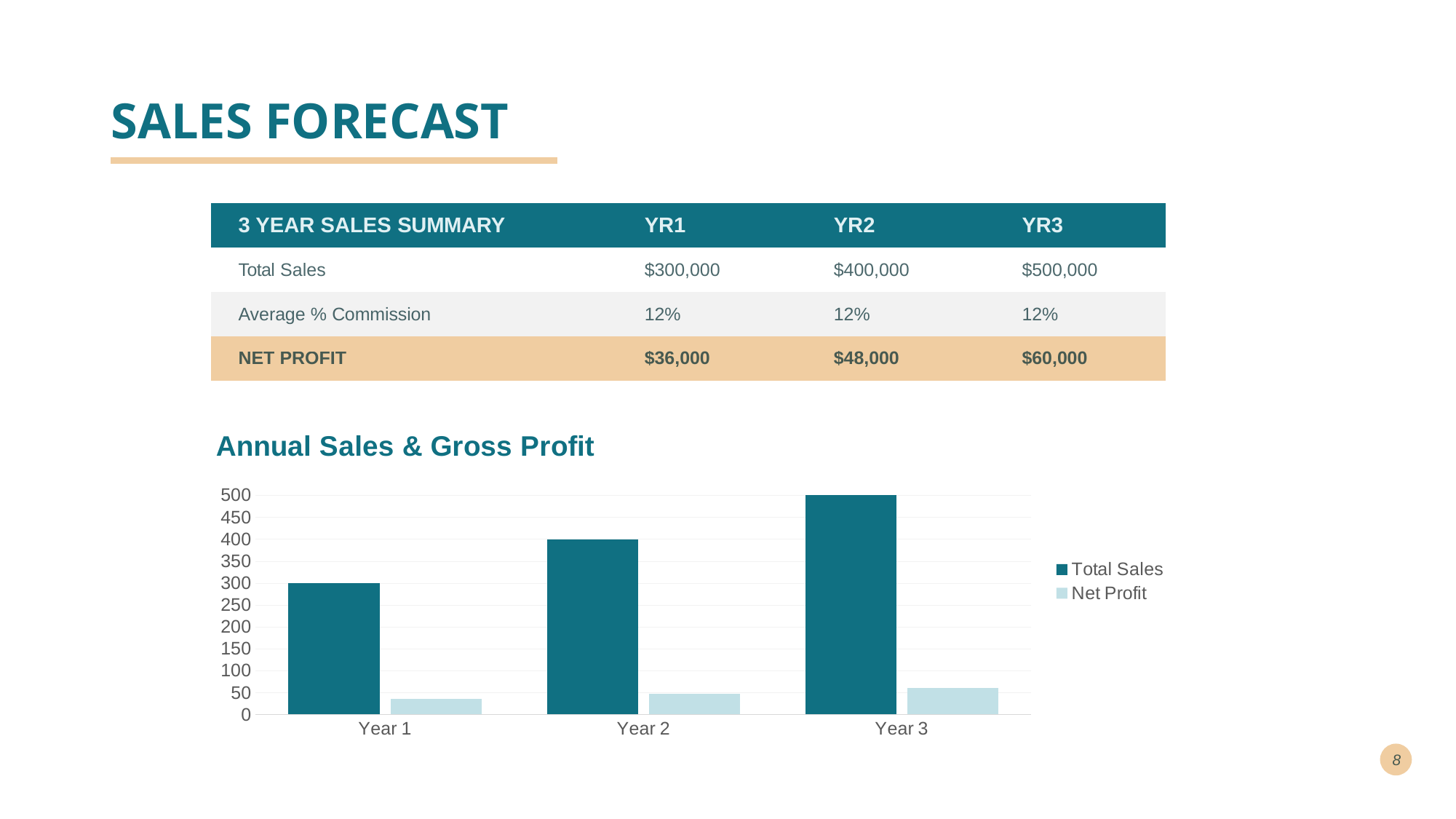
What kind of chart is shown under the title "Annual Sales & Gross Profit"? bar chart In the "Annual Sales & Gross Profit" chart, what is the Total Sales value for Year 3? 500 How many categories are shown on the x axis of the "Annual Sales & Gross Profit" chart? 3 In the "Annual Sales & Gross Profit" chart, which year has the lowest Net Profit? Year 1 In the "Annual Sales & Gross Profit" chart, which year has the highest Total Sales? Year 3 In the "Annual Sales & Gross Profit" chart, is the Net Profit value for Year 3 greater or less than 100? less What are the two legend entries in the "Annual Sales & Gross Profit" chart? Total Sales and Net Profit How many series does the legend of the "Annual Sales & Gross Profit" chart list? 2 In the "Annual Sales & Gross Profit" chart, what is the Total Sales value for Year 1? 300 In the "Annual Sales & Gross Profit" chart, which is larger for Year 2: Total Sales or Net Profit? Total Sales In the "Annual Sales & Gross Profit" chart, what is the difference between Total Sales in Year 3 and Year 1? 200 In the "Annual Sales & Gross Profit" chart, do the Total Sales values rise or fall from Year 1 to Year 3? rise